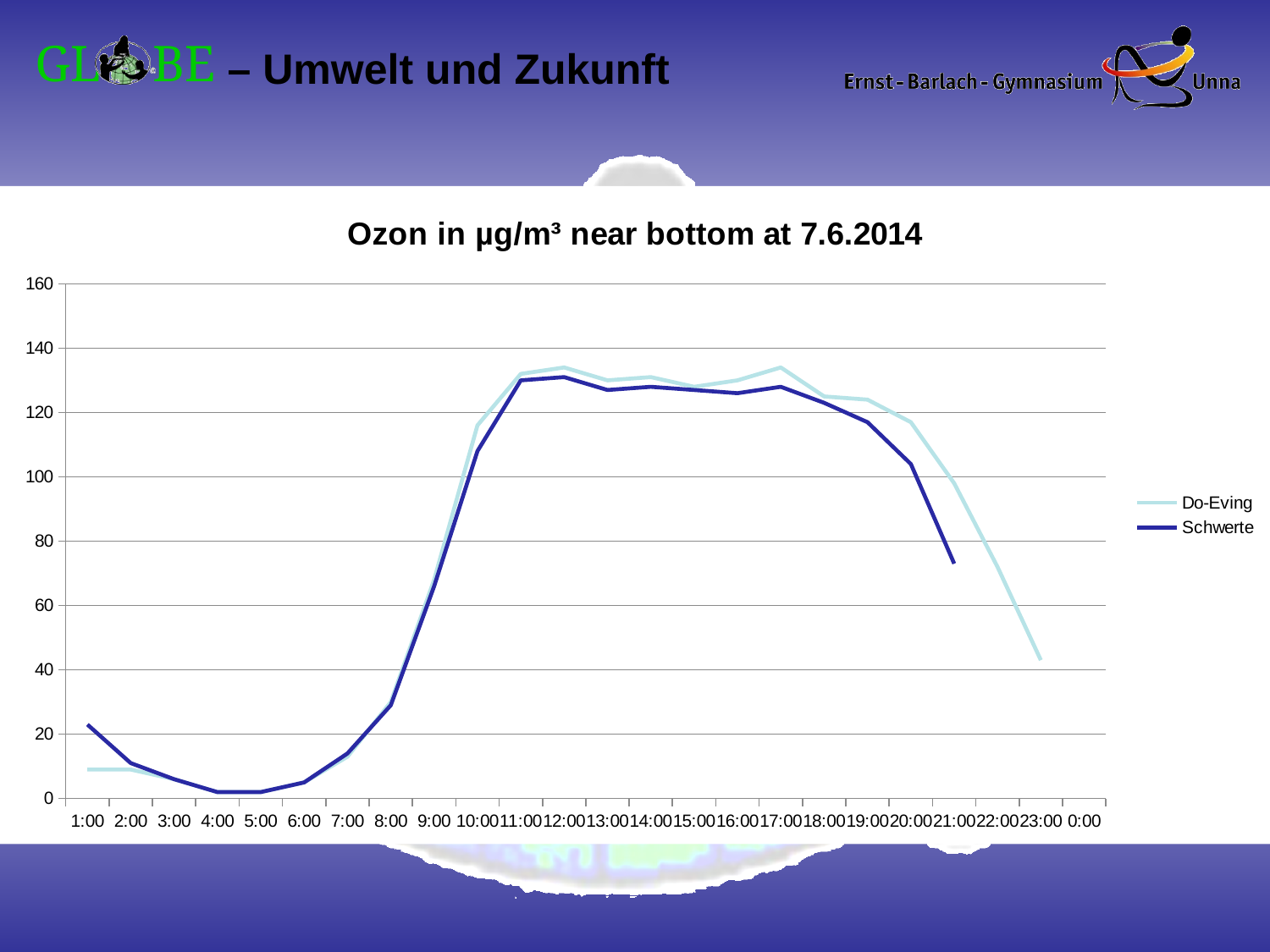
Is the value for Do-Eving at 23:00 greater or less than 60? less How many time points are labelled on the x axis? 24 Which two series are listed in the legend? Do-Eving and Schwerte Do the values for Schwerte rise or fall between 5:00 and 11:00? rise Is the value for Schwerte at 21:00 greater or less than 80? less What kind of chart is shown on the slide? line chart At 1:00, which series has the larger value, Do-Eving or Schwerte? Schwerte Is the value for Schwerte at 12:00 greater or less than 120? greater At 21:00, which series has the larger value, Do-Eving or Schwerte? Do-Eving How many series does the legend list? 2 What is the title of the chart? Ozon in µg/m³ near bottom at 7.6.2014